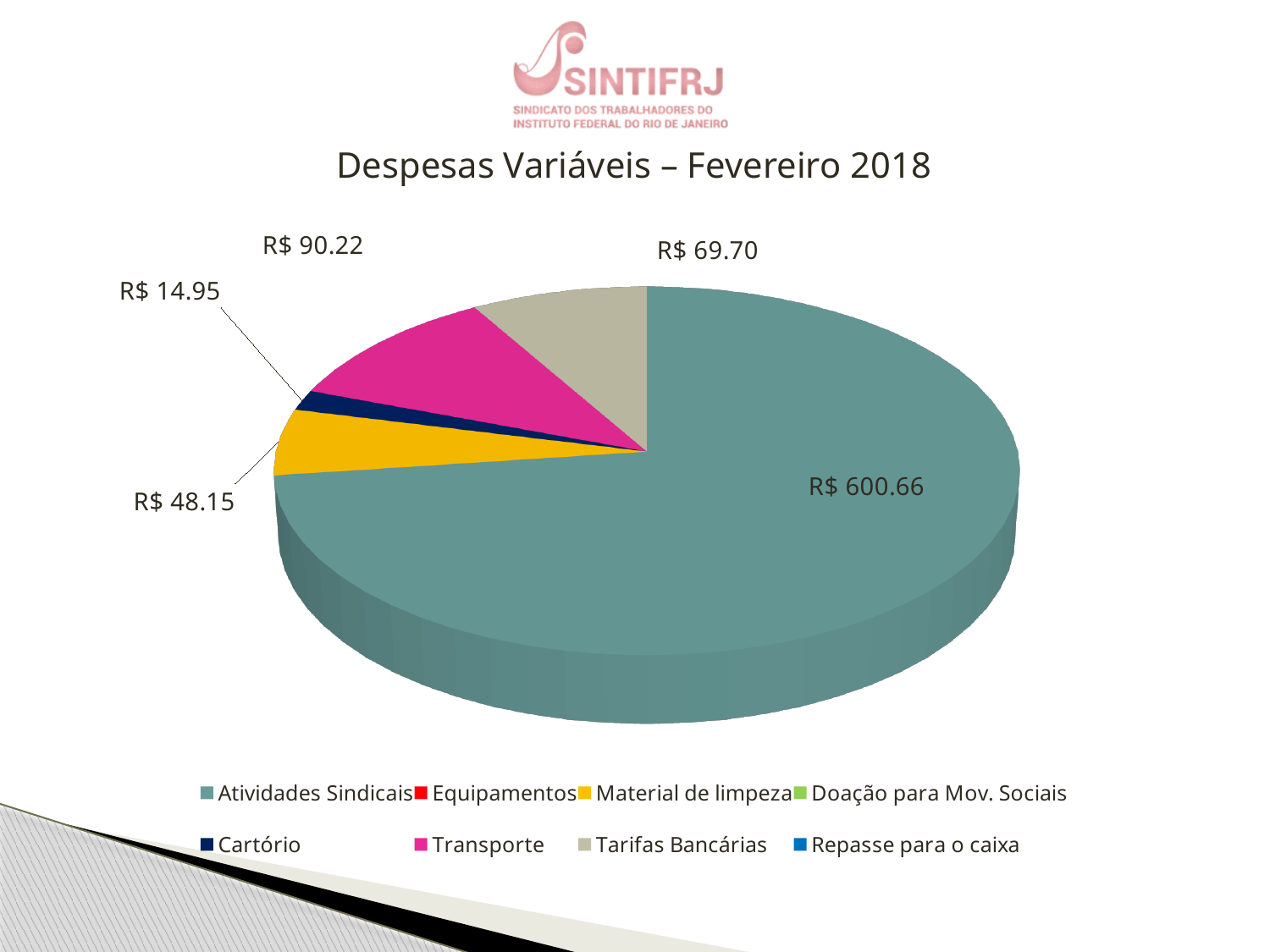
What is the value for Atividades Sindicais? R$ 600.66 What is the value for Transporte? R$ 90.22 What kind of chart is shown on the slide? Pie chart Which labeled category has the smallest value? Cartório What is the value for Cartório? R$ 14.95 How many entries does the legend list? 8 What is the difference between the values for Transporte and Tarifas Bancárias? R$ 20.52 Which is larger, the value for Material de limpeza or the value for Tarifas Bancárias? Tarifas Bancárias What is the value for Tarifas Bancárias? R$ 69.70 What is the value for Material de limpeza? R$ 48.15 Which category has the largest slice of the pie? Atividades Sindicais What is the title of the chart? Despesas Variáveis – Fevereiro 2018